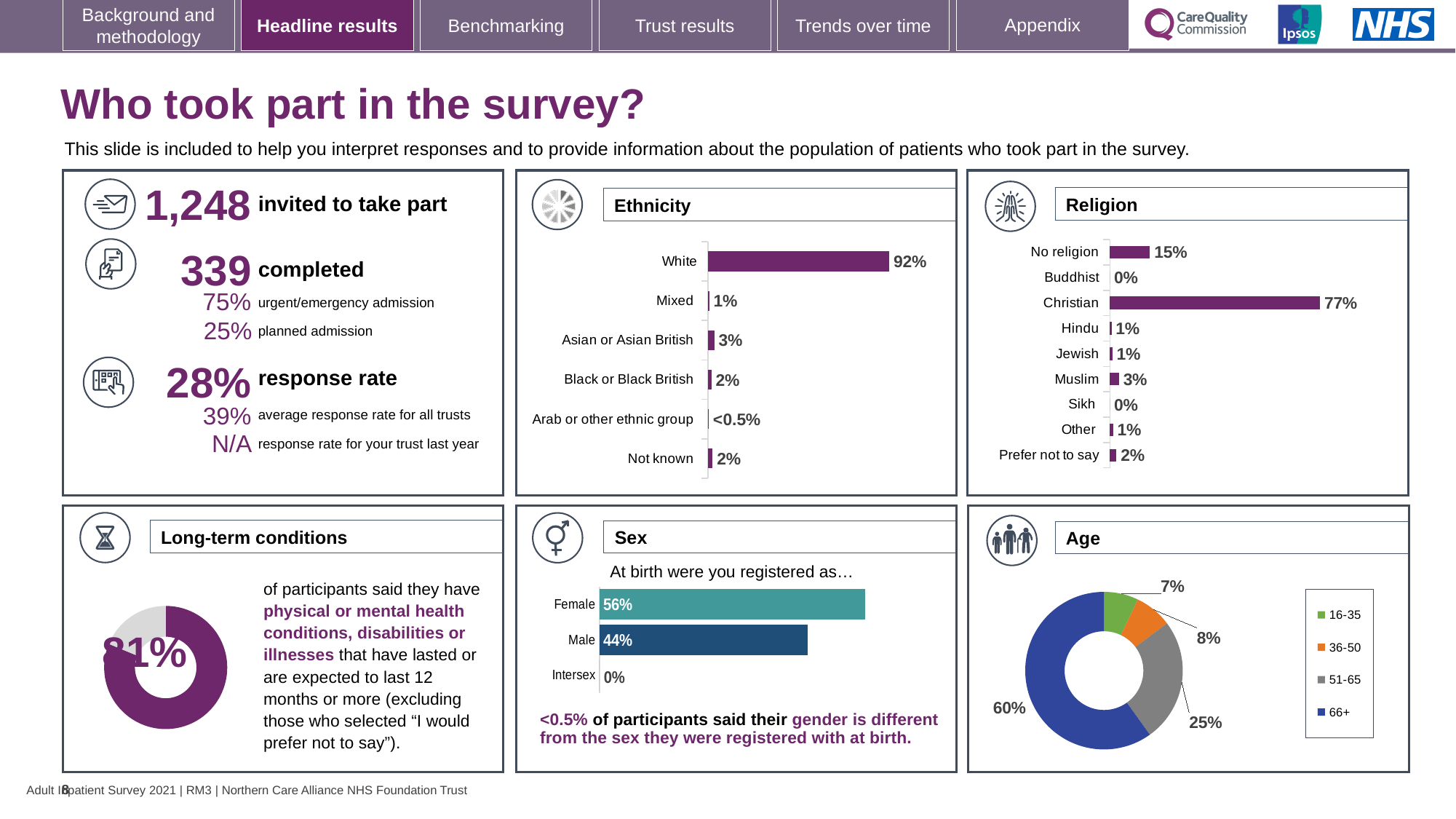
In the Religion chart, which is larger, Muslim or Hindu? Muslim What kind of chart is the Age chart? Donut chart How many categories are shown in the Religion chart? 9 How many categories are shown in the Ethnicity chart? 6 How many entries does the legend of the Age chart list? 4 In the Age chart, what share of participants were aged 66+? 60% In the Ethnicity chart, what is the value for Asian or Asian British? 3% In the Sex chart, what percentage of participants were registered as Female at birth? 56% In the Religion chart, what percentage of participants were Christian? 77% In the Ethnicity chart, which category has the highest value? White In the Religion chart, what is the difference between the Christian and No religion values? 62% In the Ethnicity chart, what percentage of participants were White? 92%